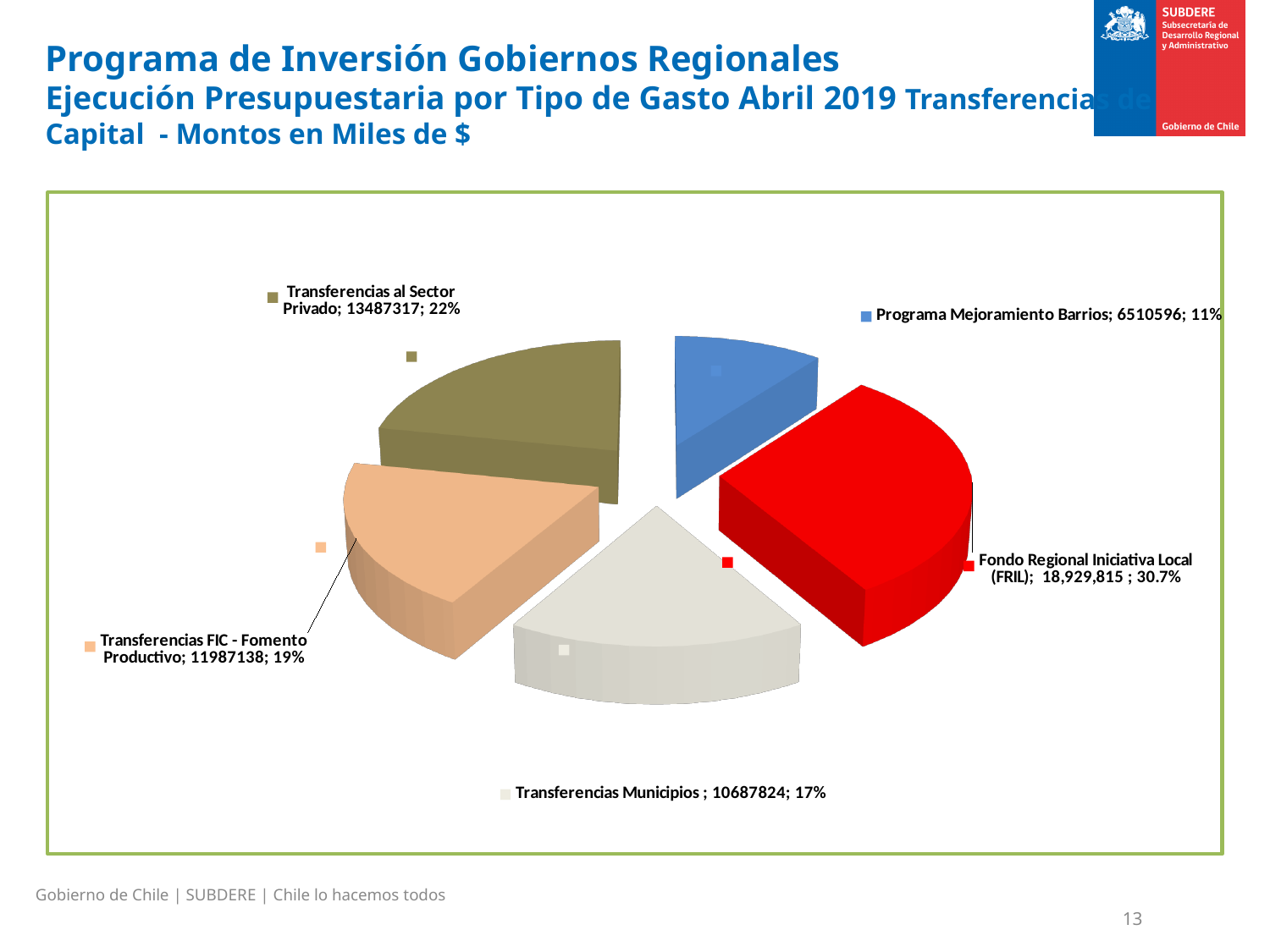
What value is shown for Programa Mejoramiento Barrios? 6510596 What kind of chart is shown on the slide? Pie chart What is the difference between the values for Transferencias al Sector Privado and Transferencias FIC - Fomento Productivo? 1500179 What value is shown for Fondo Regional Iniciativa Local (FRIL)? 18,929,815 What percentage share does Fondo Regional Iniciativa Local (FRIL) have? 30.7% What value is shown for Transferencias Municipios? 10687824 What percentage share does Transferencias FIC - Fomento Productivo have? 19% What colour is the slice for Fondo Regional Iniciativa Local (FRIL)? Red Which category has the largest slice of the pie? Fondo Regional Iniciativa Local (FRIL) How many categories are shown in the pie chart? 5 Which is larger, Transferencias Municipios or Transferencias al Sector Privado? Transferencias al Sector Privado Which category has the smallest slice of the pie? Programa Mejoramiento Barrios